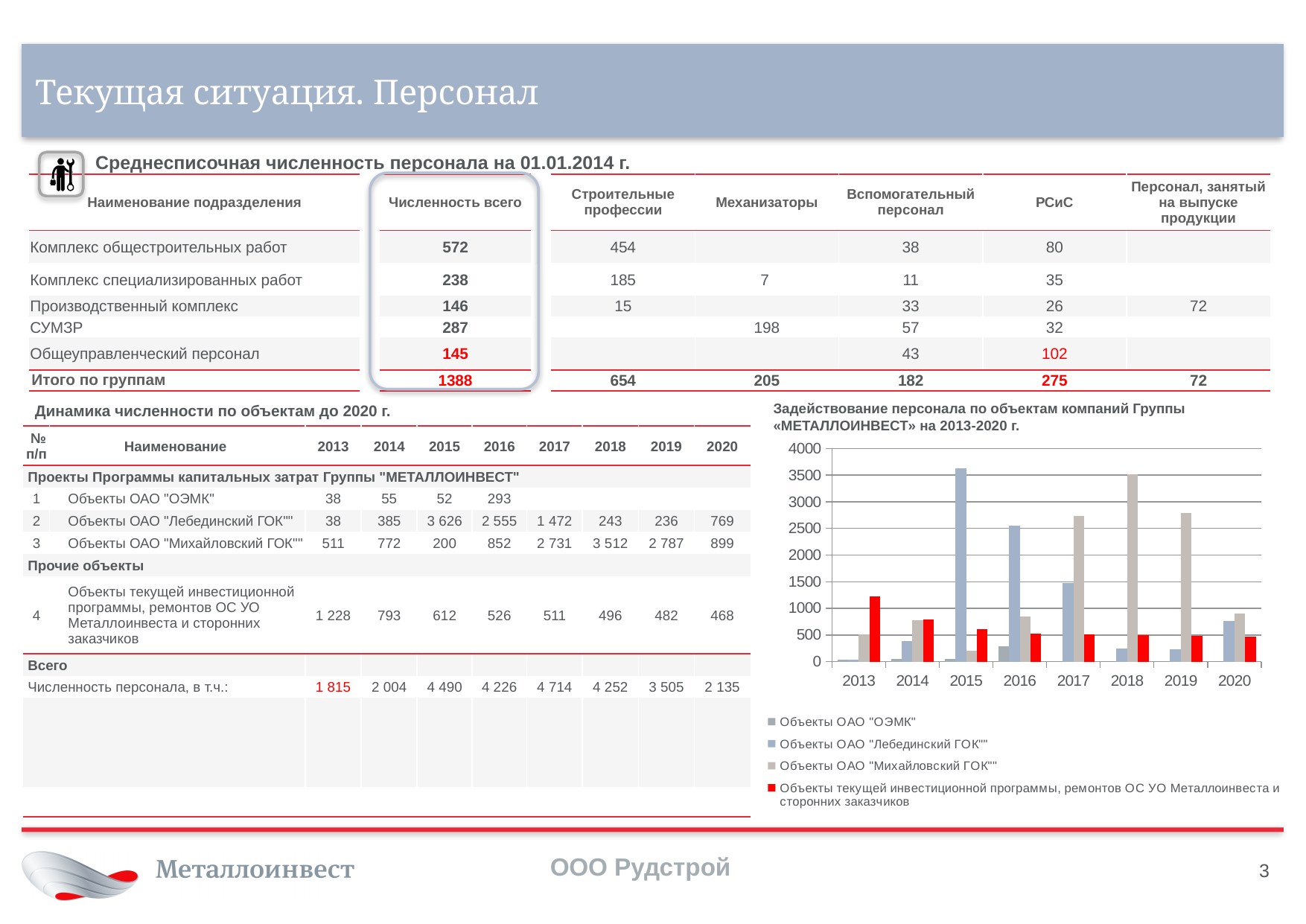
What colour are the bars for Объекты текущей инвестиционной программы, ремонтов ОС УО Металлоинвеста и сторонних заказчиков? Red How many years are shown on the x axis of the chart? 8 Does the red series (Объекты текущей инвестиционной программы, ремонтов ОС УО Металлоинвеста и сторонних заказчиков) rise or fall from 2013 to 2020? Fall What kind of chart is shown on the right side of the slide? Bar chart In which year is the bar for Объекты ОАО "Лебединский ГОК" the highest? 2015 Is the value for Объекты ОАО "ОЭМК" in 2016 greater or less than 500? less How many series does the chart legend list? 4 In 2017, which is larger: the bar for Объекты ОАО "Михайловский ГОК" or the bar for Объекты ОАО "Лебединский ГОК"? Объекты ОАО "Михайловский ГОК" Is the value for Объекты ОАО "Лебединский ГОК" in 2015 greater or less than 3000? greater Is the value for Объекты ОАО "Михайловский ГОК" in 2018 greater or less than 3000? greater In which year is the bar for Объекты ОАО "Михайловский ГОК" the highest? 2018 In which year is the red bar (Объекты текущей инвестиционной программы, ремонтов ОС УО Металлоинвеста и сторонних заказчиков) the highest? 2013